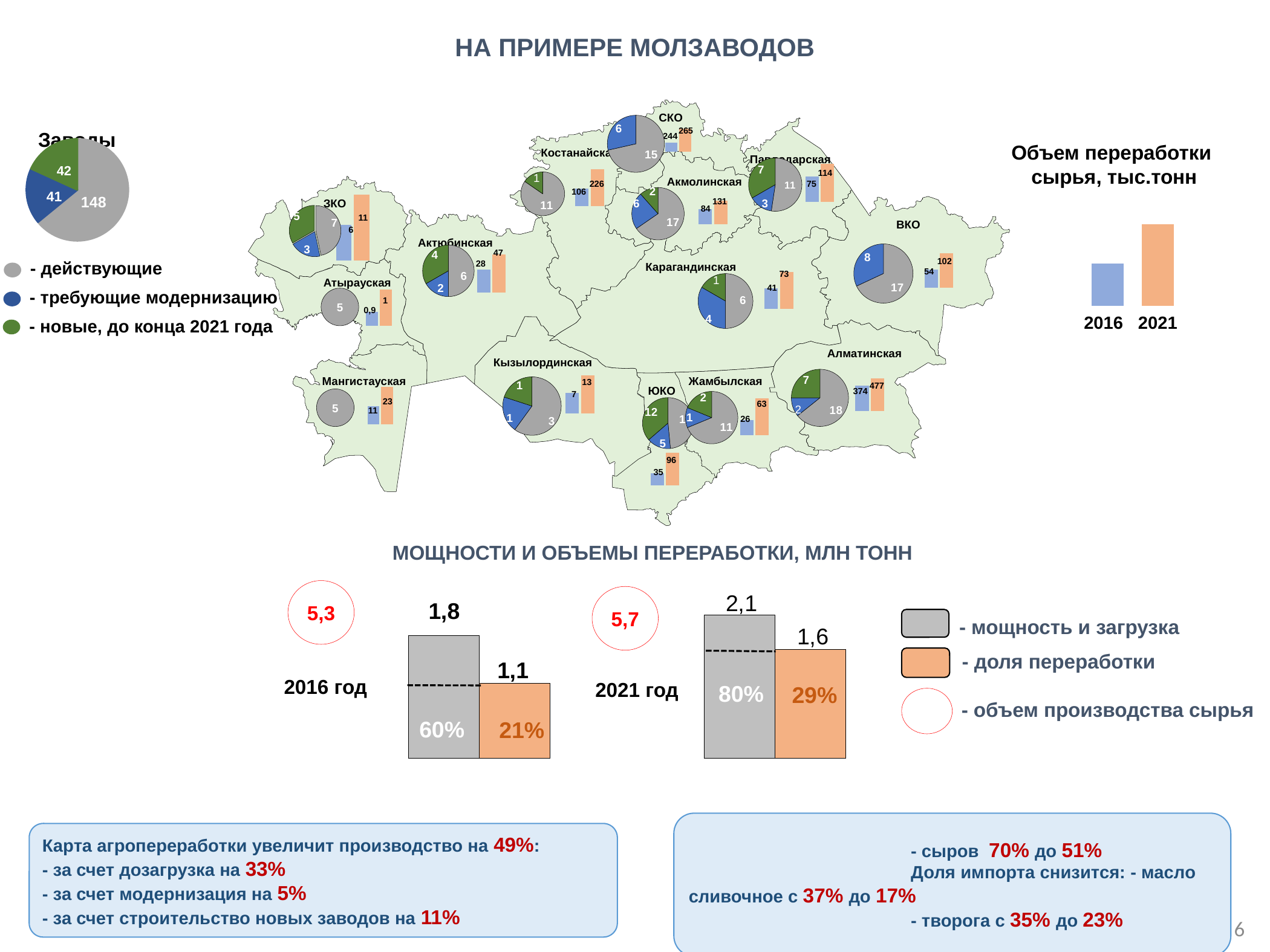
In the pie chart 'Заводы', how many categories are shown? 3 In the pie chart 'Заводы', what is the value for the 'действующие' (grey) slice? 148 On the map, which is larger: the 2021 processing volume for ЮКО or for Жамбылская? ЮКО In the chart 'Мощности и объемы переработки, млн тонн', what is the difference between the grey and orange bars for 2016 год? 0,7 On the map, what is the 2016 processing volume (тыс.тонн) for ВКО? 54 In the chart 'Мощности и объемы переработки, млн тонн', what is the value of the grey bar (мощность и загрузка) for 2021 год? 2,1 On the map, what is the 2021 processing volume (тыс.тонн) for Алматинская region? 477 In the chart 'Мощности и объемы переработки, млн тонн', what percentage is printed on the orange bar for 2021 год? 29% On the map, what is the difference between the 2021 and 2016 processing volumes for Костанайская region? 120 On the map, which region has the highest 2021 processing volume? Алматинская In the pie chart 'Заводы', what is the value for 'новые, до конца 2021 года'? 42 In the pie chart 'Заводы', which category has the largest slice? действующие